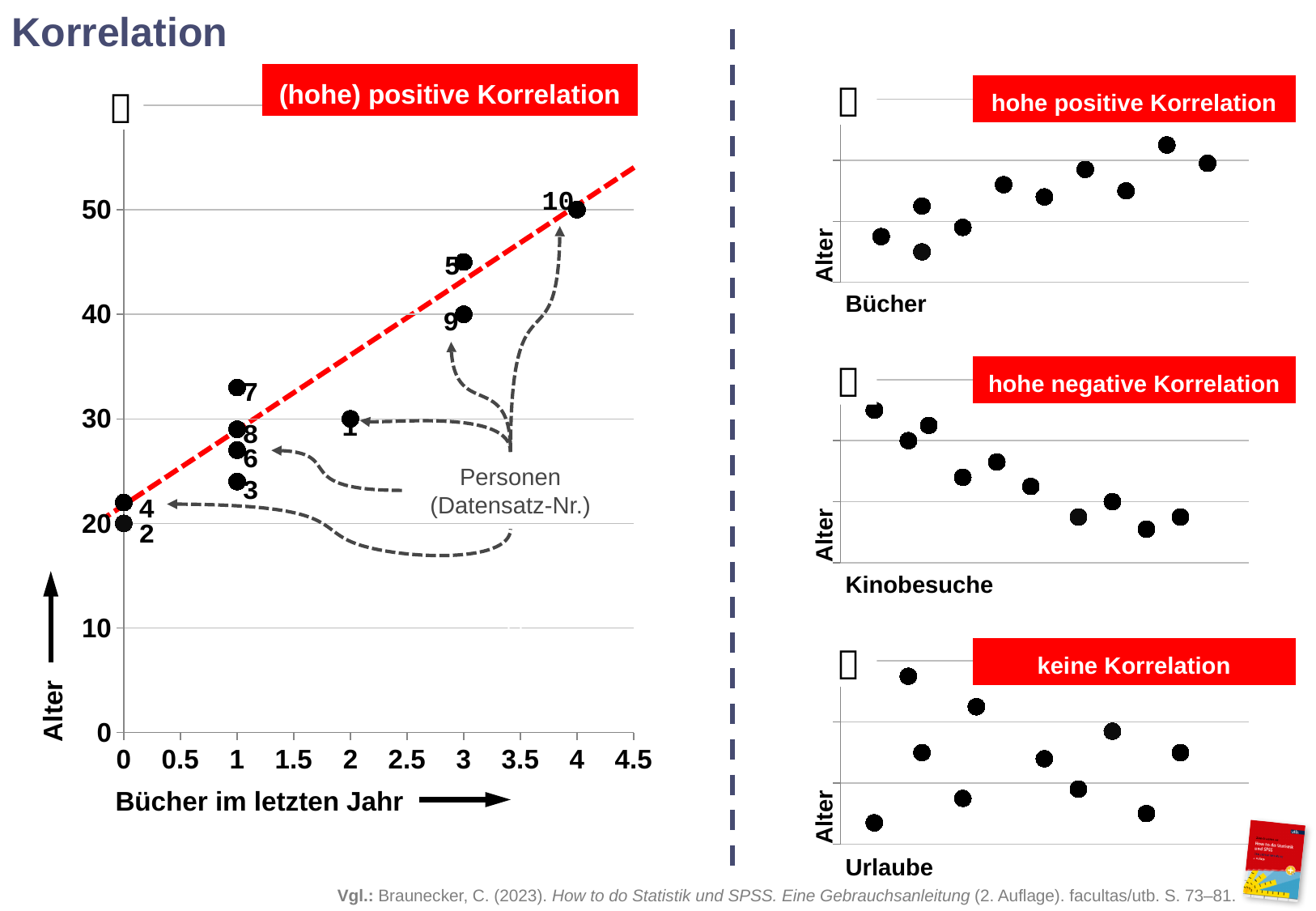
On the left chart, how many data points (persons) are plotted? 10 On the left chart, how many Bücher im letzten Jahr does person 1 have? 2 On the left chart, what is the difference in Alter between person 10 and person 9? 10 On the left chart, which person has the highest Alter value? 10 On the right side, what is the title of the chart with Kinobesuche on the x axis? hohe negative Korrelation On the left chart, which has the larger Alter value, person 9 or person 1? person 9 On the left chart, what is the Alter value for person 10? 50 On the left chart, what kind of chart is shown? scatter chart On the left chart, is the Alter value for person 3 greater or less than 30? less On the left chart, which person has the lowest Alter value? 2 On the left chart, do the Alter values rise or fall as Bücher im letzten Jahr increases? rise On the left chart, what is the Alter value for person 9? 40